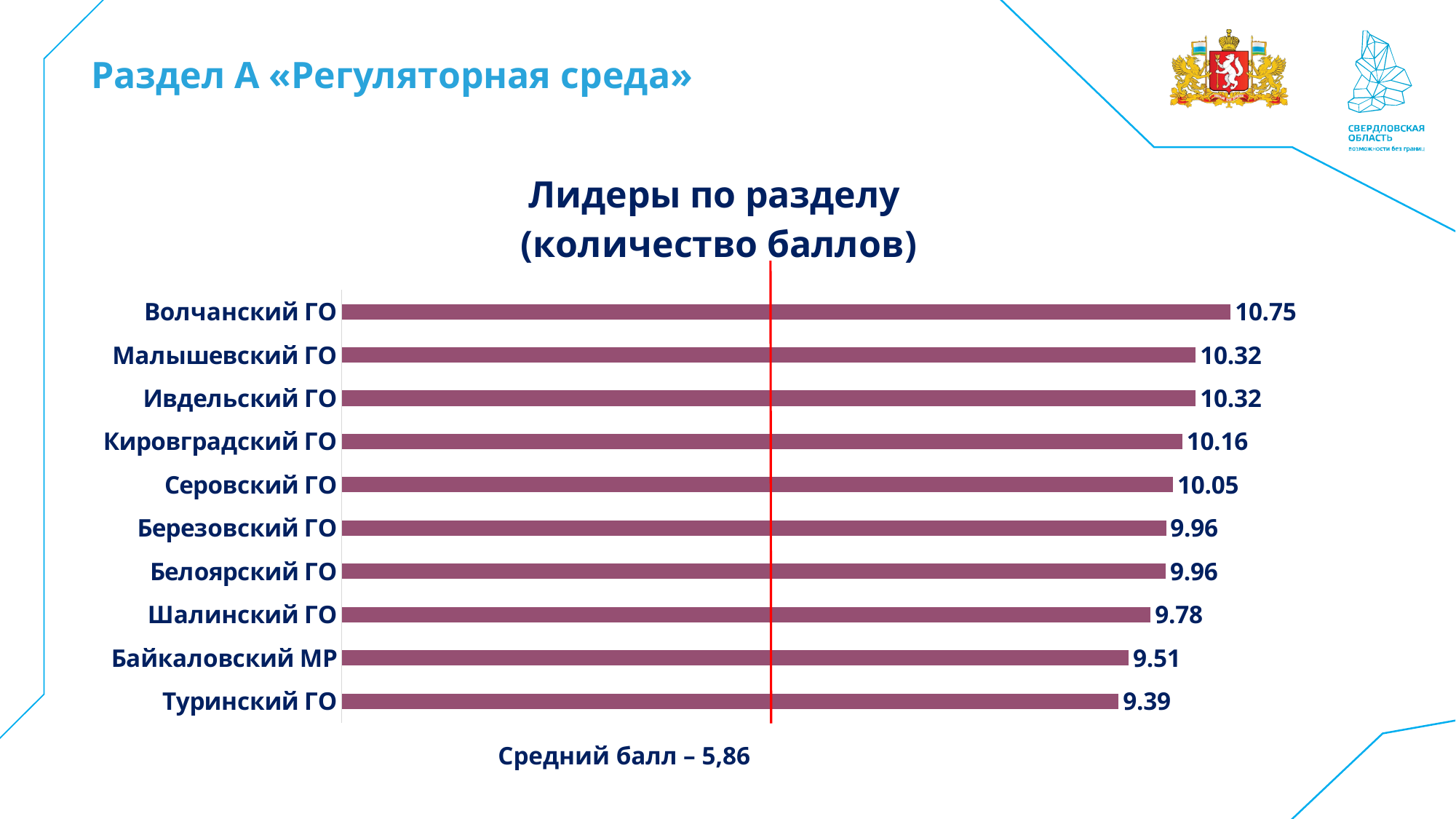
Which category has the highest value? Волчанский ГО What average score (Средний балл) is stated below the chart? 5,86 What is the title of the chart? Лидеры по разделу (количество баллов) How many categories are shown in the chart? 10 What is the difference between the values for Волчанский ГО and Туринский ГО? 1.36 What is the value for Серовский ГО? 10.05 What is the value for Волчанский ГО? 10.75 What is the difference between the values for Кировградский ГО and Шалинский ГО? 0.38 Which category has the lowest value? Туринский ГО Which is larger, the value for Малышевский ГО or the value for Березовский ГО? Малышевский ГО What is the value for Байкаловский МР? 9.51 What kind of chart is shown on the slide? bar chart